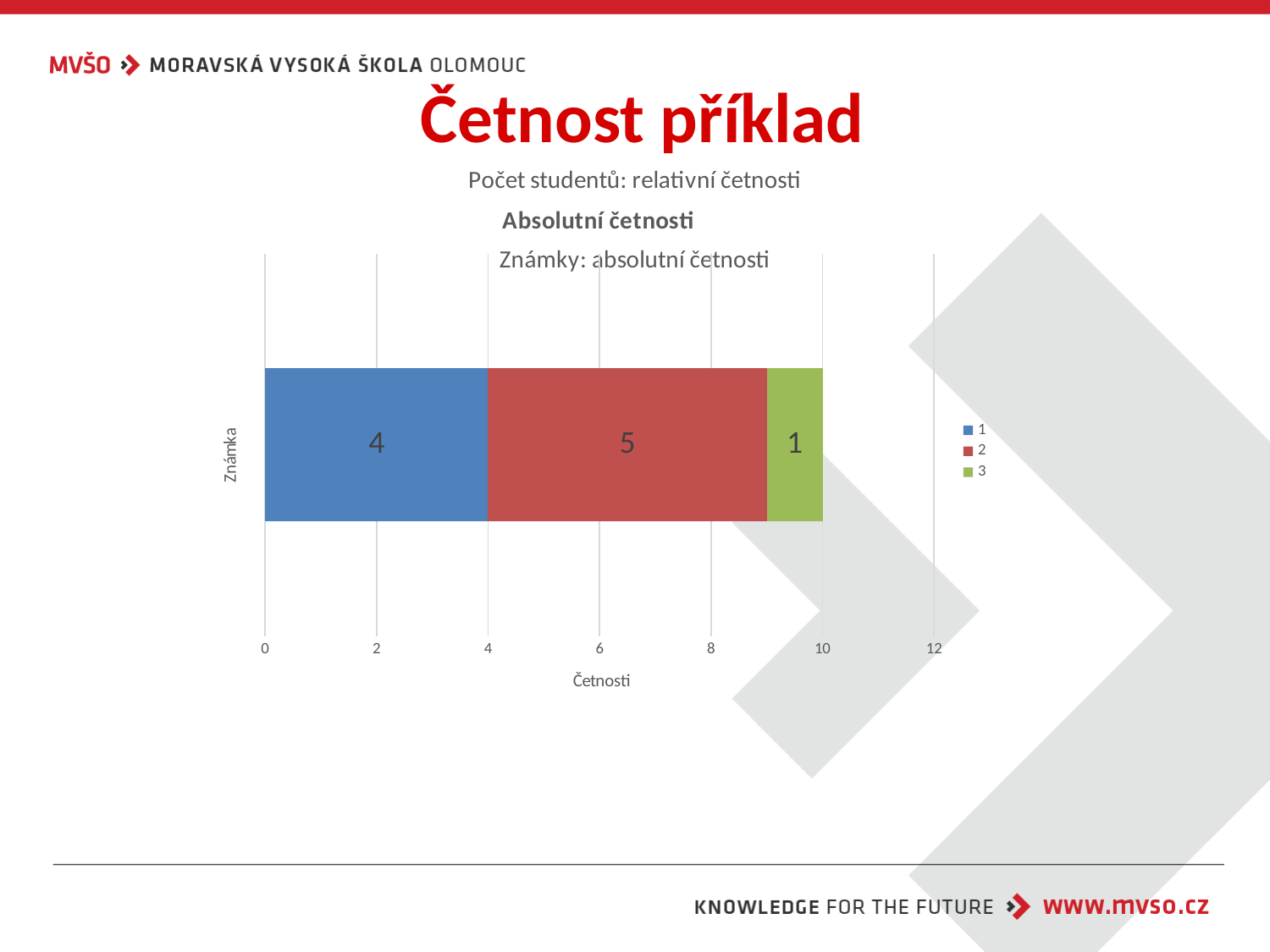
What is the difference between the values for series 2 and series 1? 1 What is the value for series 1 (the blue segment)? 4 What is the total of the stacked bar? 10 What is the value for series 3 (the green segment)? 1 What is the value for series 2 (the red segment)? 5 Which series has the highest value in the bar? 2 Which series has the lowest value in the bar? 3 What is the label of the horizontal axis? Četnosti What kind of chart is shown on the slide? stacked bar chart How many series does the chart legend list? 3 Which is larger, the value for series 1 or the value for series 3? series 1